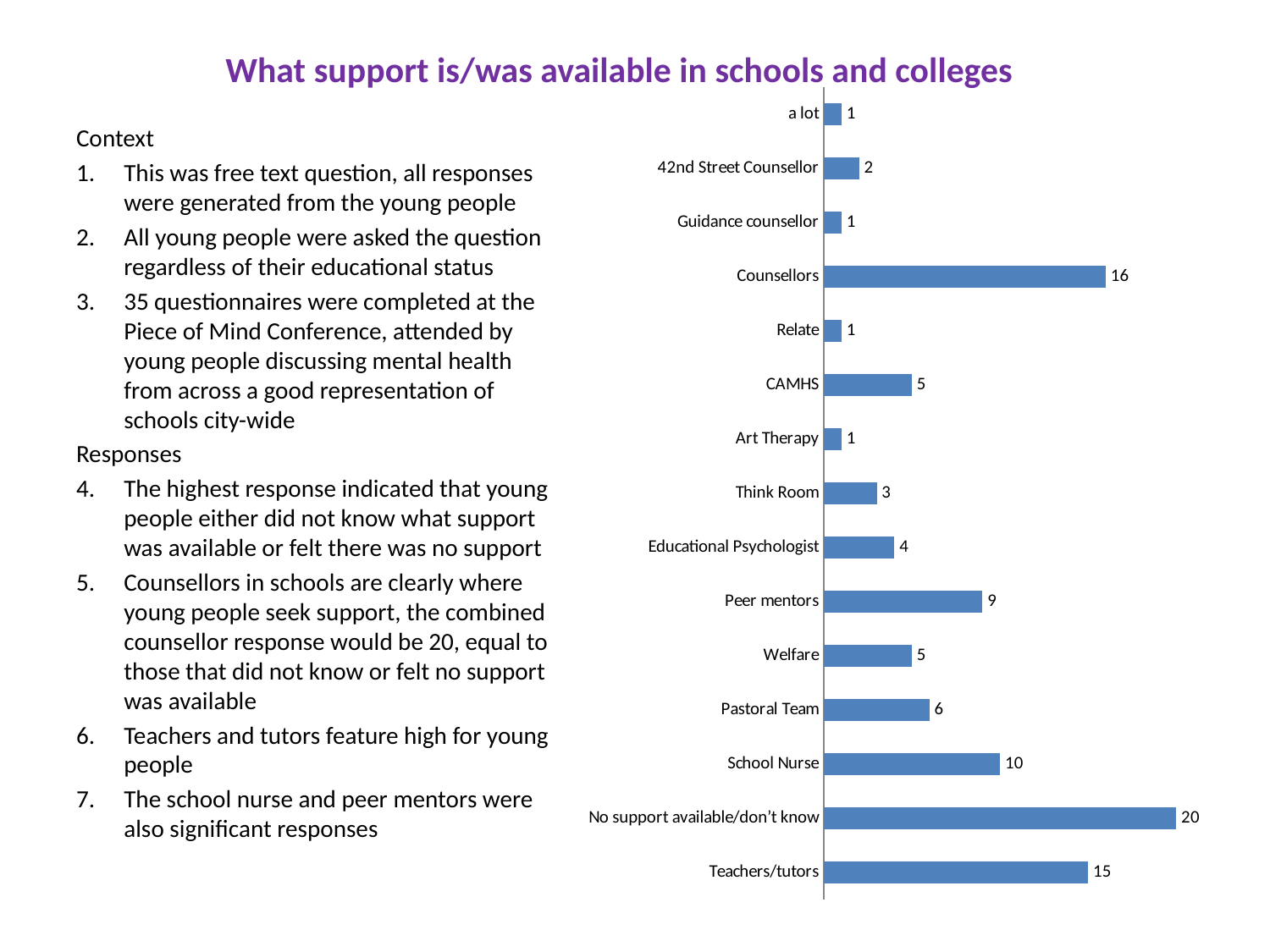
What kind of chart is shown on the slide? Bar chart What value is shown for CAMHS? 5 What value is shown for Teachers/tutors? 15 What value is shown for Counsellors? 16 What is the difference between the values for Counsellors and Peer mentors? 7 How many categories are shown in the chart? 15 What is the difference between the values for No support available/don't know and Teachers/tutors? 5 What value is shown for Peer mentors? 9 What value is shown for School Nurse? 10 Which is larger, the value for Pastoral Team or the value for Welfare? Pastoral Team Which is larger, the value for Think Room or the value for Educational Psychologist? Educational Psychologist Which category has the highest value? No support available/don't know